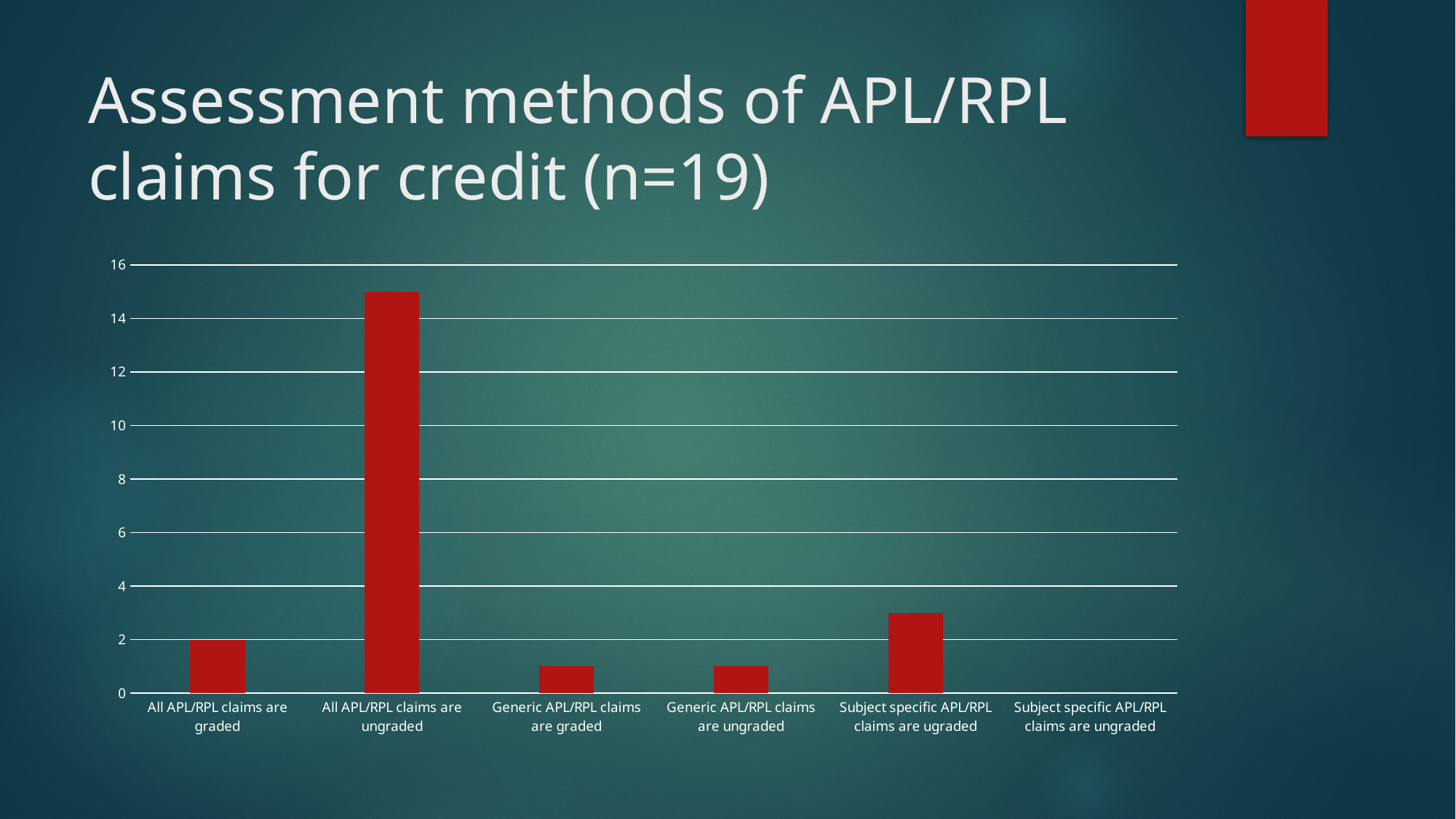
Is the value for 'Subject specific APL/RPL claims are ugraded' greater or less than 4? less What type of chart is shown on the slide? Bar chart What is the title of the slide containing the chart? Assessment methods of APL/RPL claims for credit (n=19) What is the value for 'All APL/RPL claims are graded'? 2 Is the value for 'All APL/RPL claims are ungraded' greater or less than 14? greater Which is larger: the value for 'Subject specific APL/RPL claims are ugraded' or the value for 'Generic APL/RPL claims are ungraded'? Subject specific APL/RPL claims are ugraded What colour are the bars in the chart? Red Which category has the lowest value in the chart? Subject specific APL/RPL claims are ungraded Which category has the highest value in the chart? All APL/RPL claims are ungraded Which is larger: the value for 'All APL/RPL claims are ungraded' or the value for 'Subject specific APL/RPL claims are ugraded'? All APL/RPL claims are ungraded How many categories are shown on the x axis of the chart? 6 Is the value for 'Generic APL/RPL claims are graded' greater or less than 2? less